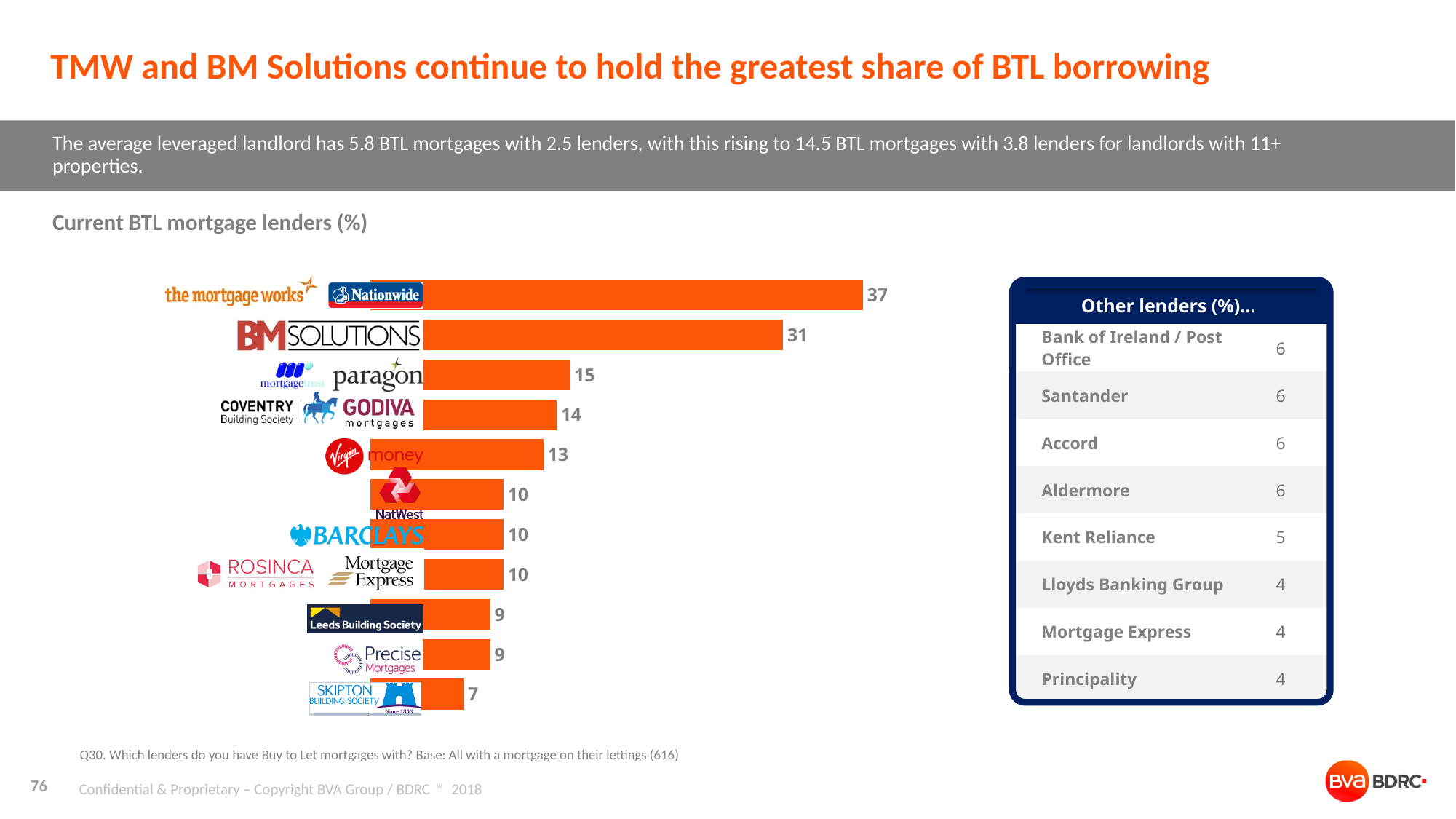
What is the value for The Mortgage Works / Nationwide in the Current BTL mortgage lenders chart? 37 Which lender has the highest value in the Current BTL mortgage lenders chart? The Mortgage Works / Nationwide What is the difference between the values for The Mortgage Works / Nationwide and BM Solutions in the Current BTL mortgage lenders chart? 6 What is the value for Virgin Money in the Current BTL mortgage lenders chart? 13 Which lender has the lowest value in the Current BTL mortgage lenders chart? Skipton Building Society What kind of chart is the Current BTL mortgage lenders chart? Bar chart How many lenders are shown as bars in the Current BTL mortgage lenders chart? 11 What is the value for Skipton Building Society in the Current BTL mortgage lenders chart? 7 What is the value for BM Solutions in the Current BTL mortgage lenders chart? 31 What is the title of the chart on the slide? Current BTL mortgage lenders (%) What is the difference between the values for Paragon and Coventry Building Society / Godiva in the Current BTL mortgage lenders chart? 1 Which has a larger value in the Current BTL mortgage lenders chart, Virgin Money or Leeds Building Society? Virgin Money